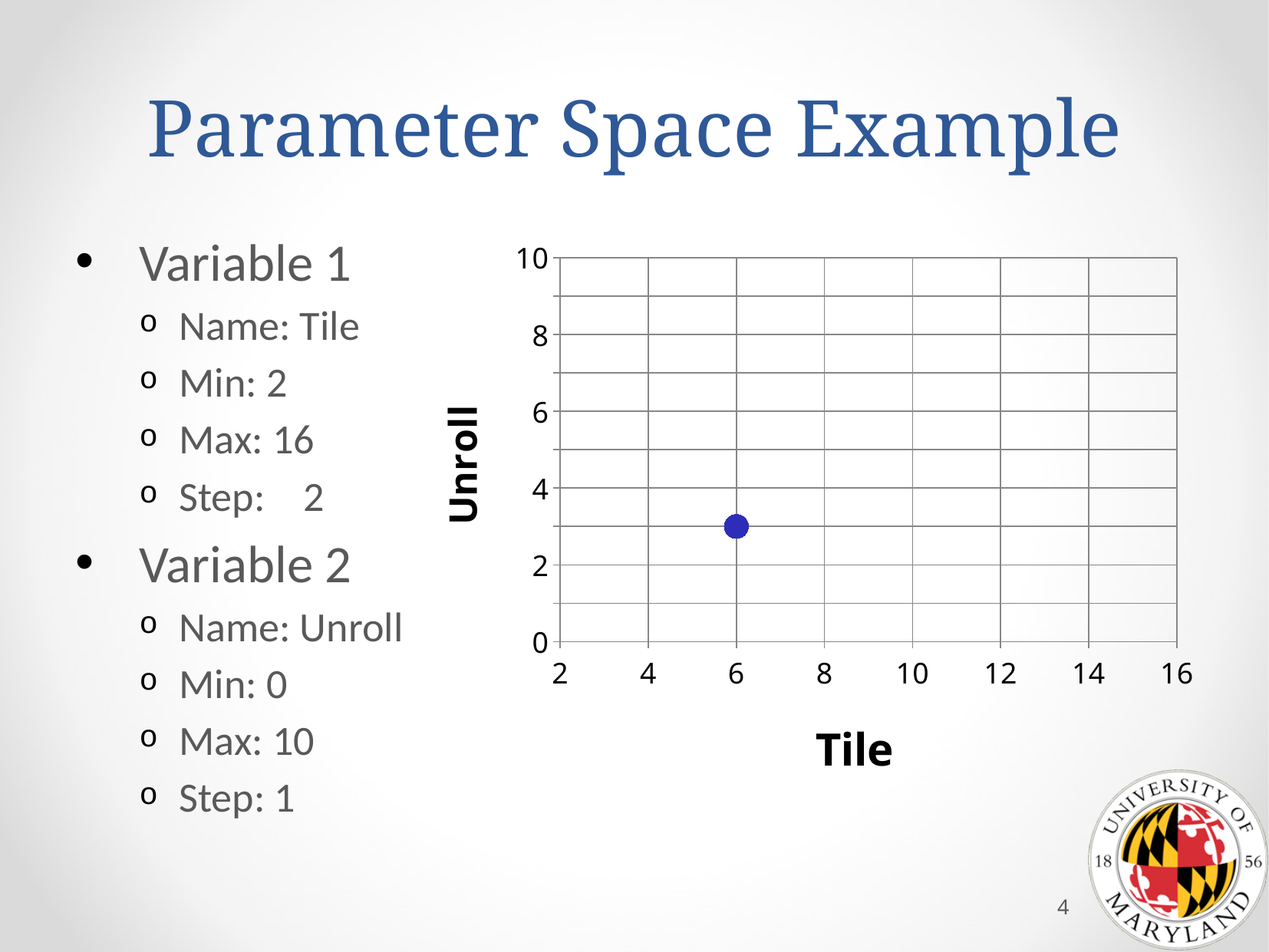
What is the label of the y axis? Unroll Is the Unroll value of the plotted point greater or less than 2? greater Is the Unroll value of the plotted point greater or less than 4? less What is the label of the x axis? Tile What is the Tile value of the plotted point? 6 Is the Tile value of the plotted point greater or less than 10? less How many data points are plotted on the chart? 1 What kind of chart is shown on the slide? scatter chart